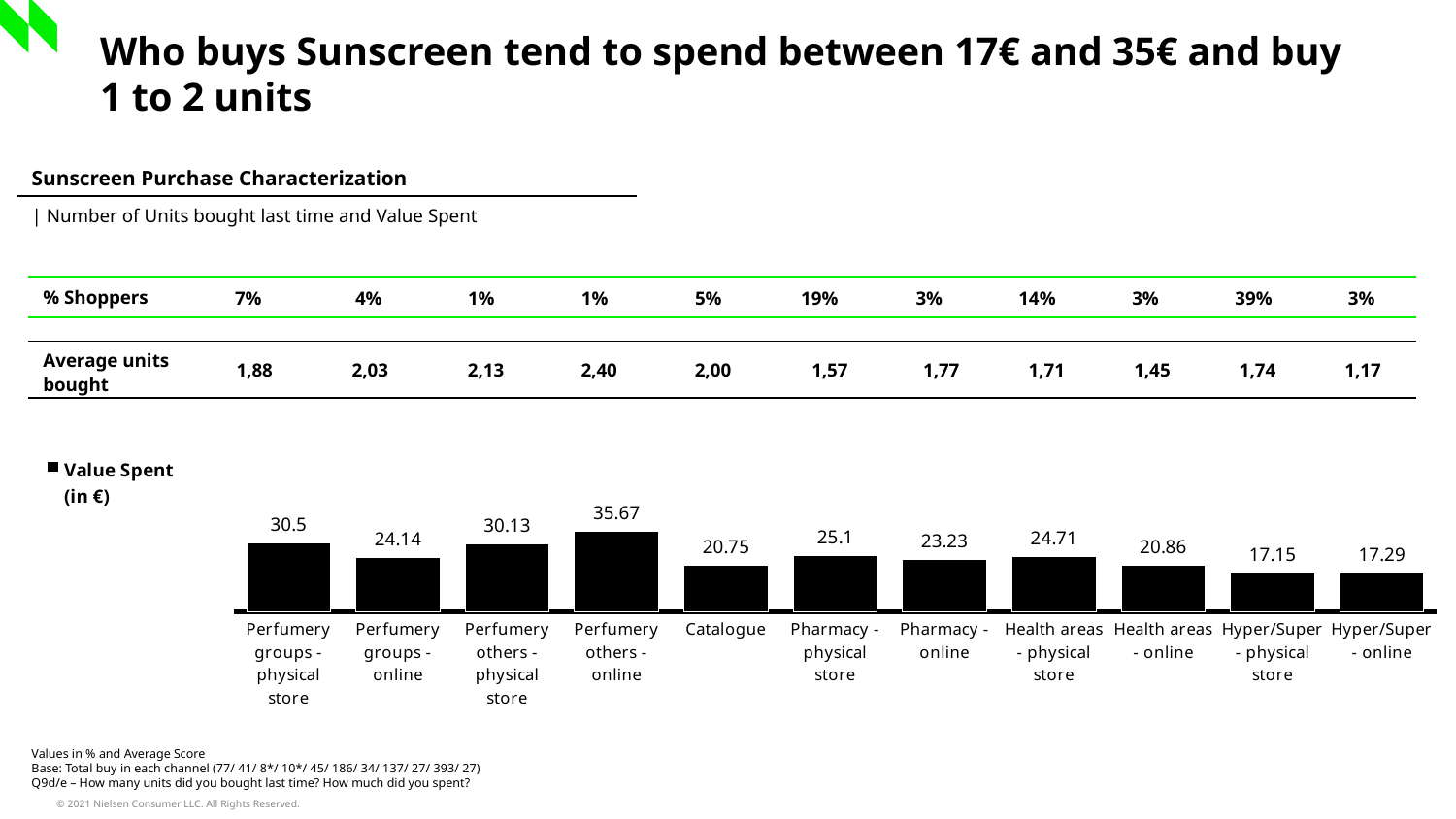
What is the legend entry of the chart? Value Spent (in €) What is the difference in value spent between Perfumery others - online and Hyper/Super - physical store? 18.52 Which channel has the lowest value spent in the bar chart? Hyper/Super - physical store What is the value spent (in €) for Health areas - physical store? 24.71 What is the value spent (in €) for Perfumery others - online? 35.67 Which has a higher value spent: Perfumery groups - physical store or Pharmacy - physical store? Perfumery groups - physical store What kind of chart is used to show Value Spent? Bar chart What is the difference in value spent between Perfumery groups - physical store and Perfumery groups - online? 6.36 What is the value spent (in €) for Catalogue? 20.75 Which channel has the highest value spent in the bar chart? Perfumery others - online How many channels are shown in the Value Spent bar chart? 11 How many series does the legend of the Value Spent chart list? 1